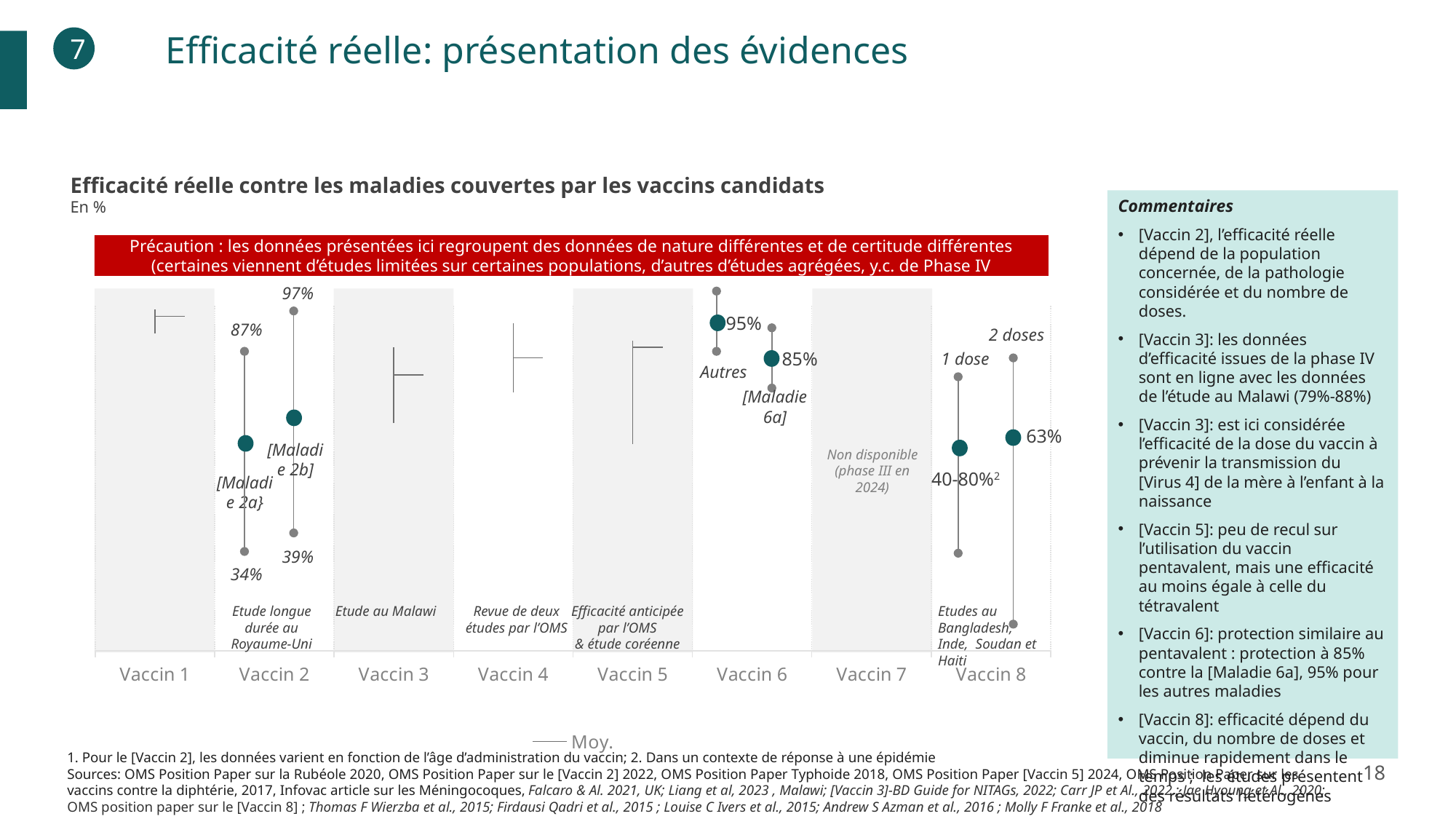
What efficacy value is shown for [Maladie 6a] under Vaccin 6? 85% What is the lower value shown for [Maladie 2b] under Vaccin 2? 39% What is the lower value shown for [Maladie 2a] under Vaccin 2? 34% What is the upper value shown for [Maladie 2b] under Vaccin 2? 97% Which vaccine is marked as 'Non disponible' in the chart? Vaccin 7 What is the difference between the 'Autres' value and the [Maladie 6a] value under Vaccin 6? 10 percentage points Under Vaccin 6, which is higher: the value for 'Autres' or for [Maladie 6a]? Autres What efficacy value is shown for 'Autres' under Vaccin 6? 95% How many vaccine categories are shown on the x axis of the chart? 8 What is the upper value shown for [Maladie 2a] under Vaccin 2? 87% What efficacy value is shown for 2 doses under Vaccin 8? 63% What efficacy range is shown for 1 dose under Vaccin 8? 40-80%